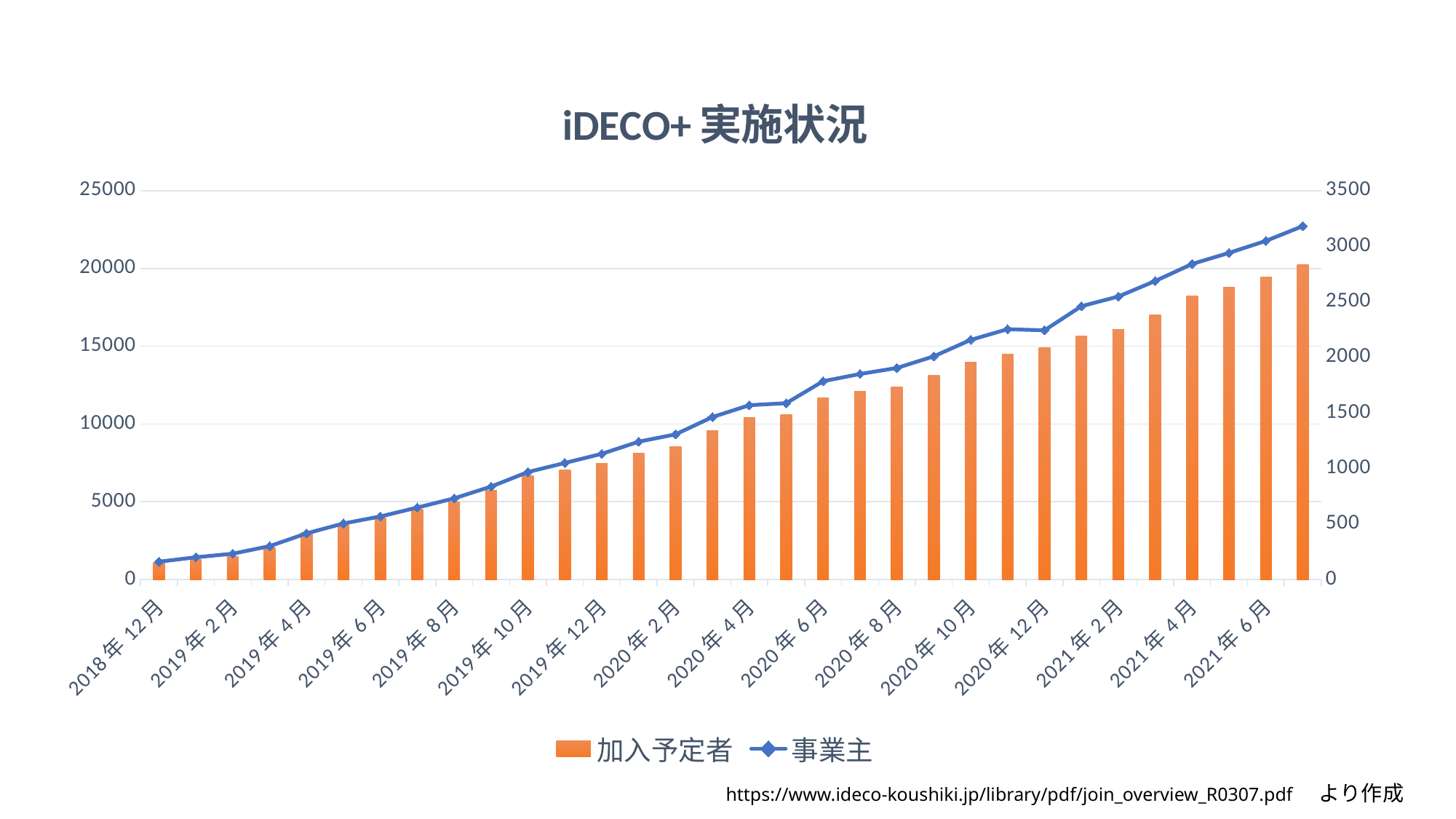
Which month has the lowest 加入予定者 value? 2018年12月 How many series does the legend list? 2 Which series is drawn as a line with diamond markers? 事業主 Do the 加入予定者 values rise or fall from 2018年12月 to the end of the x axis? Rise Which is larger, the 加入予定者 value for 2020年2月 or for 2020年10月? 2020年10月 Is the 加入予定者 value for 2020年8月 greater or less than 10000? greater Is the 事業主 value for 2020年12月 greater or less than 2000 on the right axis? greater Is the 加入予定者 value for 2021年6月 greater or less than 20000? less What kind of chart is shown on the slide? A combination bar and line chart What is the title of the chart? iDECO+ 実施状況 How many monthly bars are plotted for 加入予定者? 32